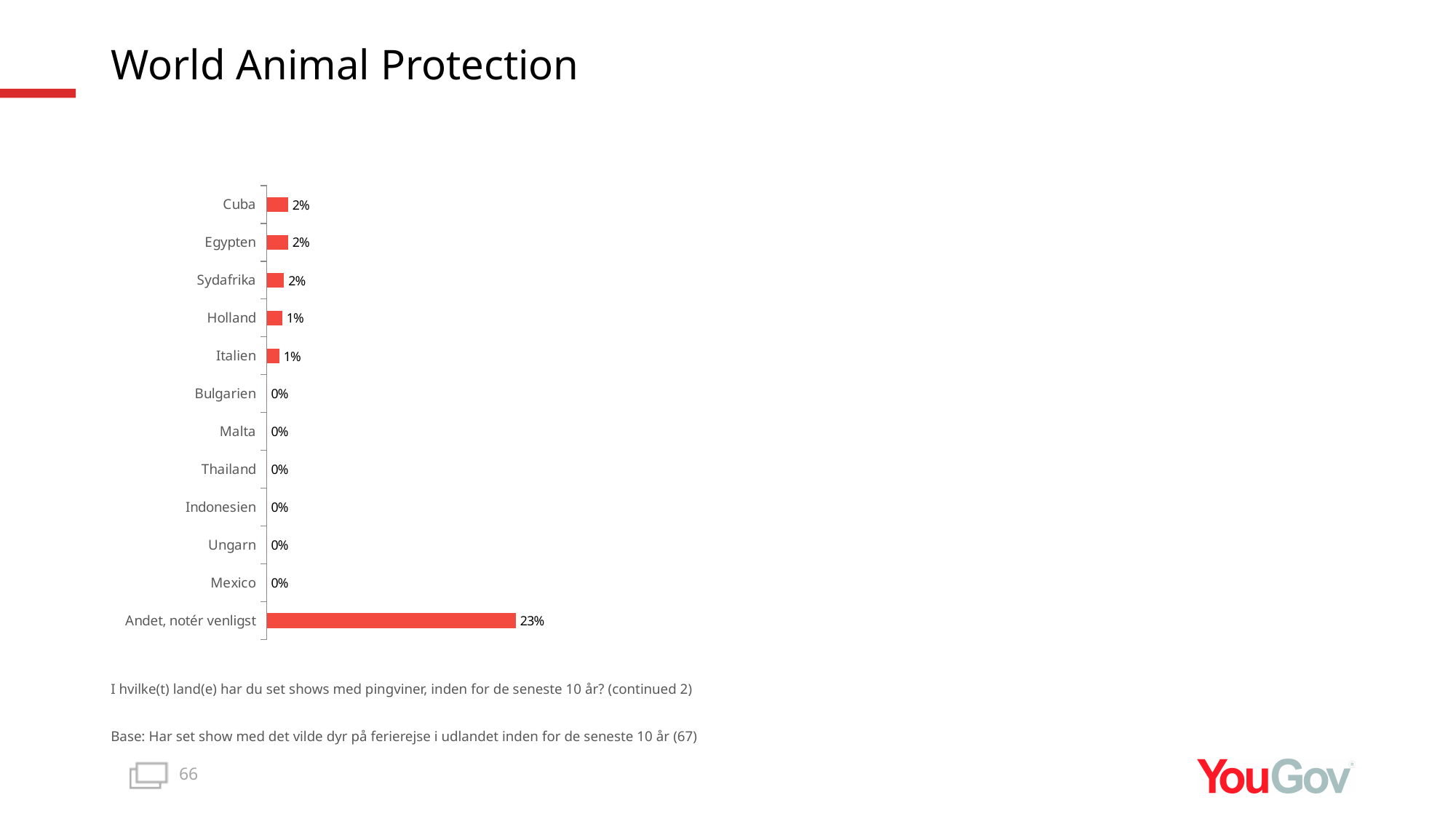
How many categories are shown in the chart? 12 What is the difference between the values for Andet, notér venligst and Cuba? 21% Which category has the highest value? Andet, notér venligst What is the difference between the values for Sydafrika and Italien? 1% What kind of chart is shown on the slide? Bar chart What colour are the bars in the chart? Red What is the value for Holland? 1% What is the value for Andet, notér venligst? 23% Which is larger, the value for Egypten or the value for Holland? Egypten What is the value for Cuba? 2% What is the value for Thailand? 0% How many categories have a value of 0%? 6